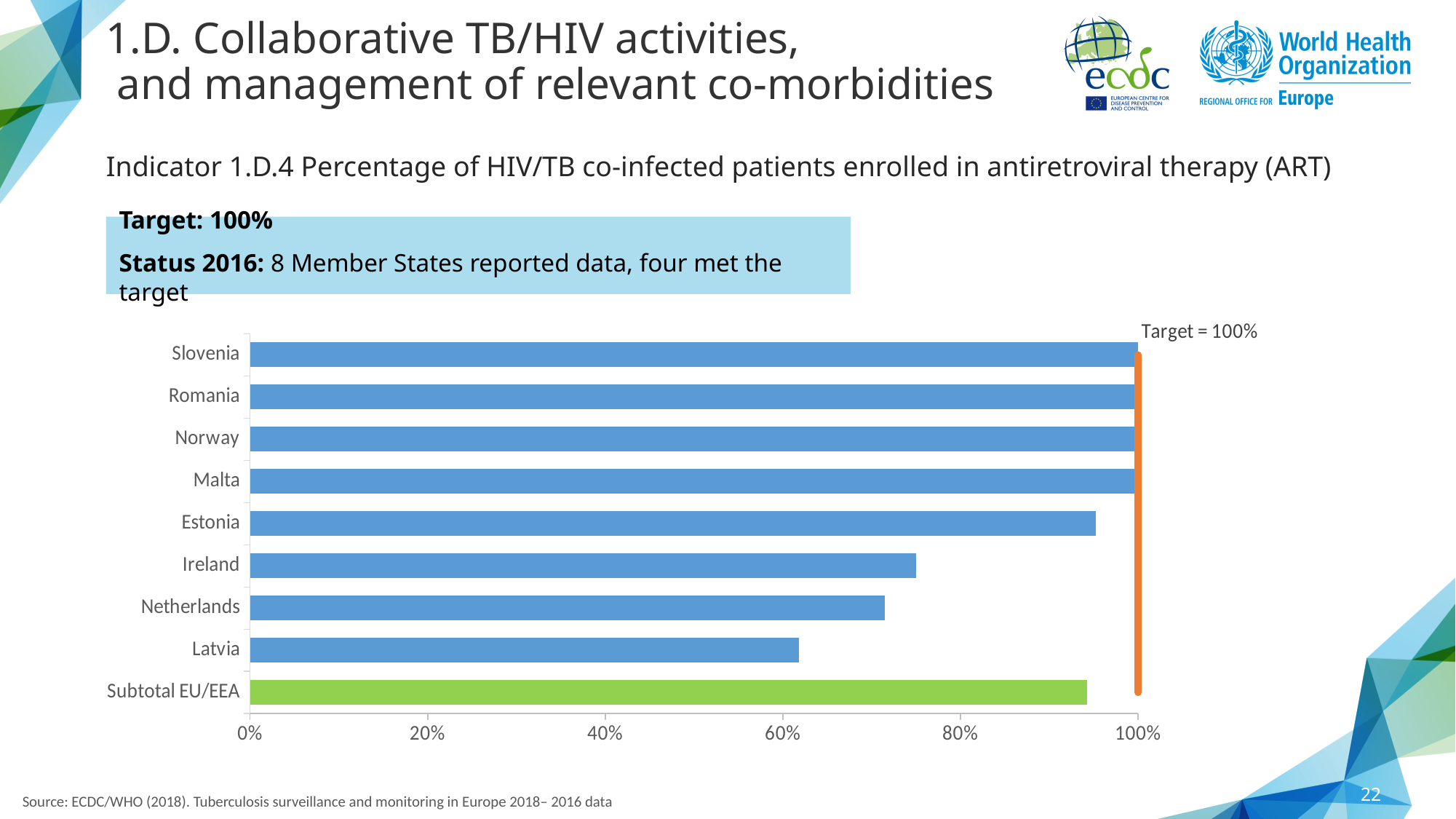
Which bar in the chart is coloured green rather than blue? Subtotal EU/EEA What is the value for Malta? 100% Is the value for Netherlands greater or less than 60%? greater Which has the larger value, Ireland or Netherlands? Ireland Is the value for Estonia greater or less than 80%? greater Is the value for Ireland greater or less than 80%? less What kind of chart is shown on the slide? bar chart What target value is marked by the vertical line in the chart? Target = 100% Which country has the lowest value in the chart? Latvia What is the value for Slovenia? 100% How many bars are plotted in the chart? 9